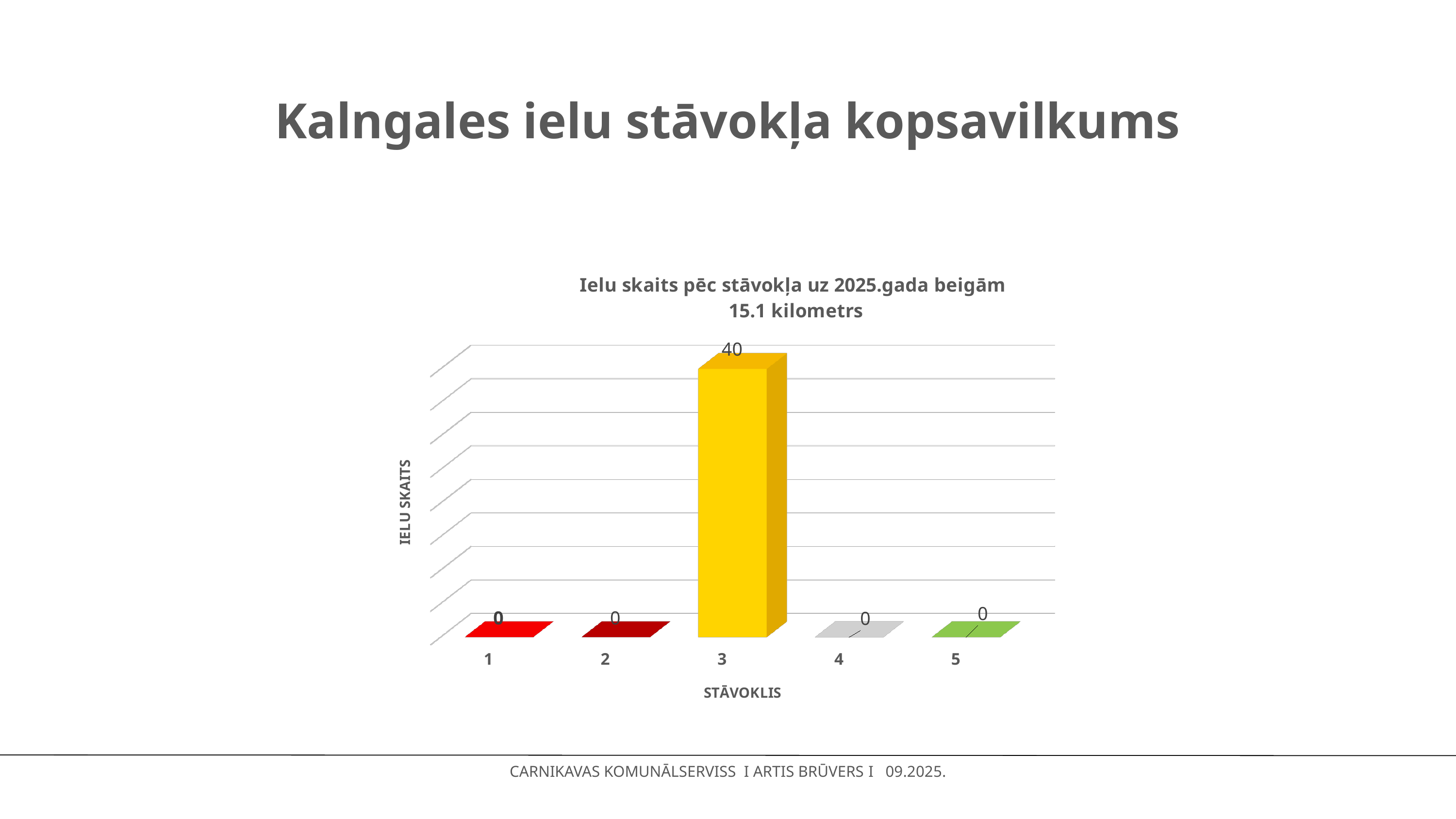
What is the value for category 3? 40 Which category has the highest value? 3 What is the title of the chart? Ielu skaits pēc stāvokļa uz 2025.gada beigām 15.1 kilometrs How many categories have a value of 0? 4 How many categories are shown on the x axis? 5 What is the value for category 1? 0 What is the value for category 5? 0 What is the difference between the values for category 3 and category 4? 40 Which is larger, the value for category 3 or the value for category 2? category 3 What is the label of the x axis? STĀVOKLIS What kind of chart is shown on the slide? bar chart